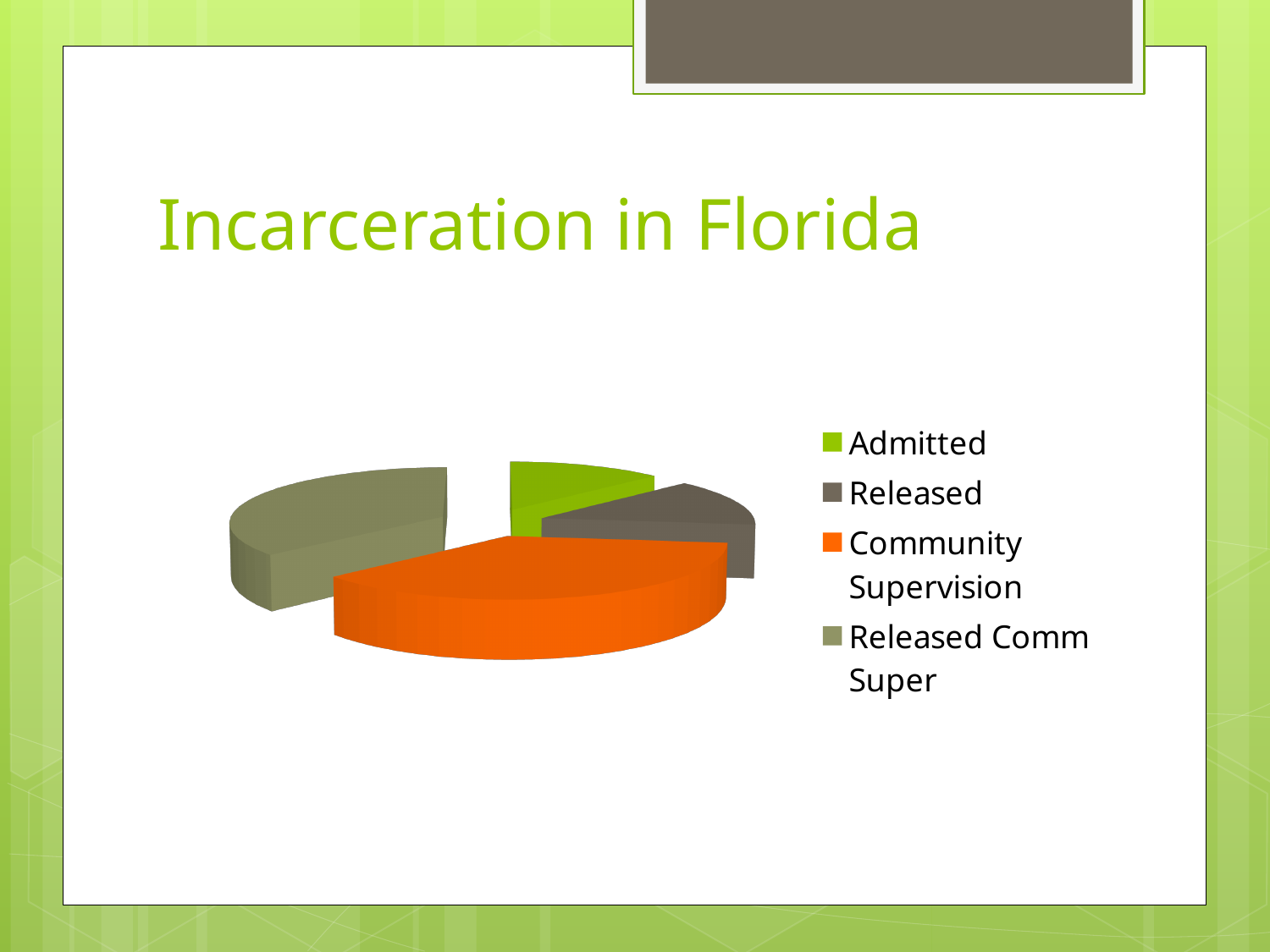
How many slices does the pie chart have? 4 How many entries does the legend of the pie chart list? 4 Which slice is larger, Admitted or Community Supervision? Community Supervision What colour is the Community Supervision slice in the pie chart? orange Which slice is larger, Released or Released Comm Super? Released Comm Super What is the title of the slide containing the pie chart? Incarceration in Florida What kind of chart is shown on the slide? pie chart